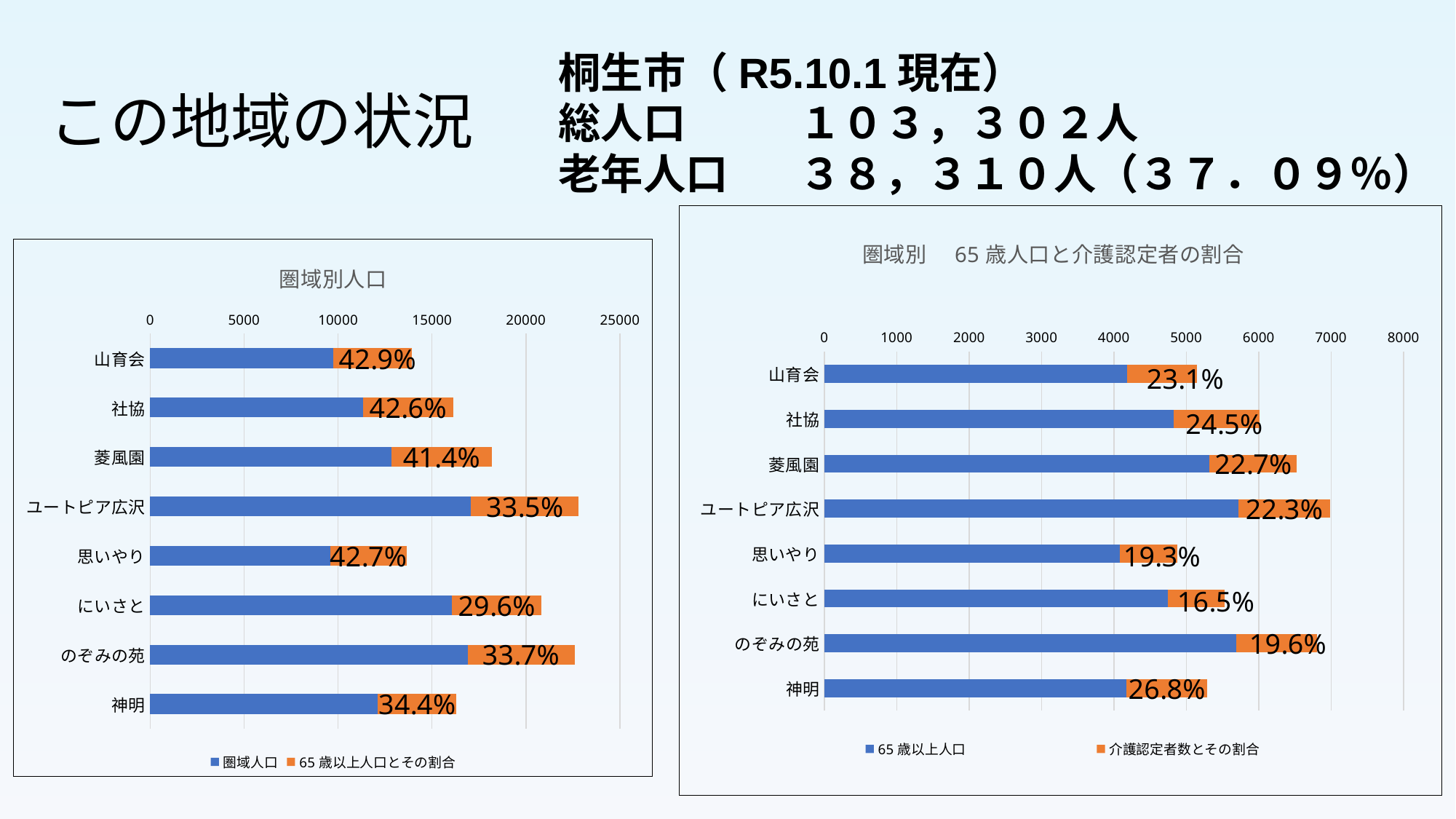
In the 圏域別人口 chart on the left, what is the difference between the percentage labels for 山育会 and 神明? 8.5% How many series does the legend of the 圏域別 65歳人口と介護認定者の割合 chart on the right list? 2 In the 圏域別 65歳人口と介護認定者の割合 chart on the right, which category has the lowest percentage label? にいさと In the 圏域別 65歳人口と介護認定者の割合 chart on the right, what percentage label is shown for 神明? 26.8% In the 圏域別人口 chart on the left, what percentage label is shown for にいさと? 29.6% In the 圏域別人口 chart on the left, how many categories are plotted? 8 In the 圏域別 65歳人口と介護認定者の割合 chart on the right, which category has the highest percentage label? 神明 In the 圏域別 65歳人口と介護認定者の割合 chart on the right, which has the larger percentage label, 社協 or 菱風園? 社協 In the 圏域別人口 chart on the left, what percentage label is shown for 山育会? 42.9% In the 圏域別 65歳人口と介護認定者の割合 chart on the right, is the blue 65歳以上人口 bar for にいさと greater or less than 5000? less In the 圏域別人口 chart on the left, which category has the lowest percentage label? にいさと In the 圏域別人口 chart on the left, is the blue 圏域人口 bar for ユートピア広沢 greater or less than 15000? greater